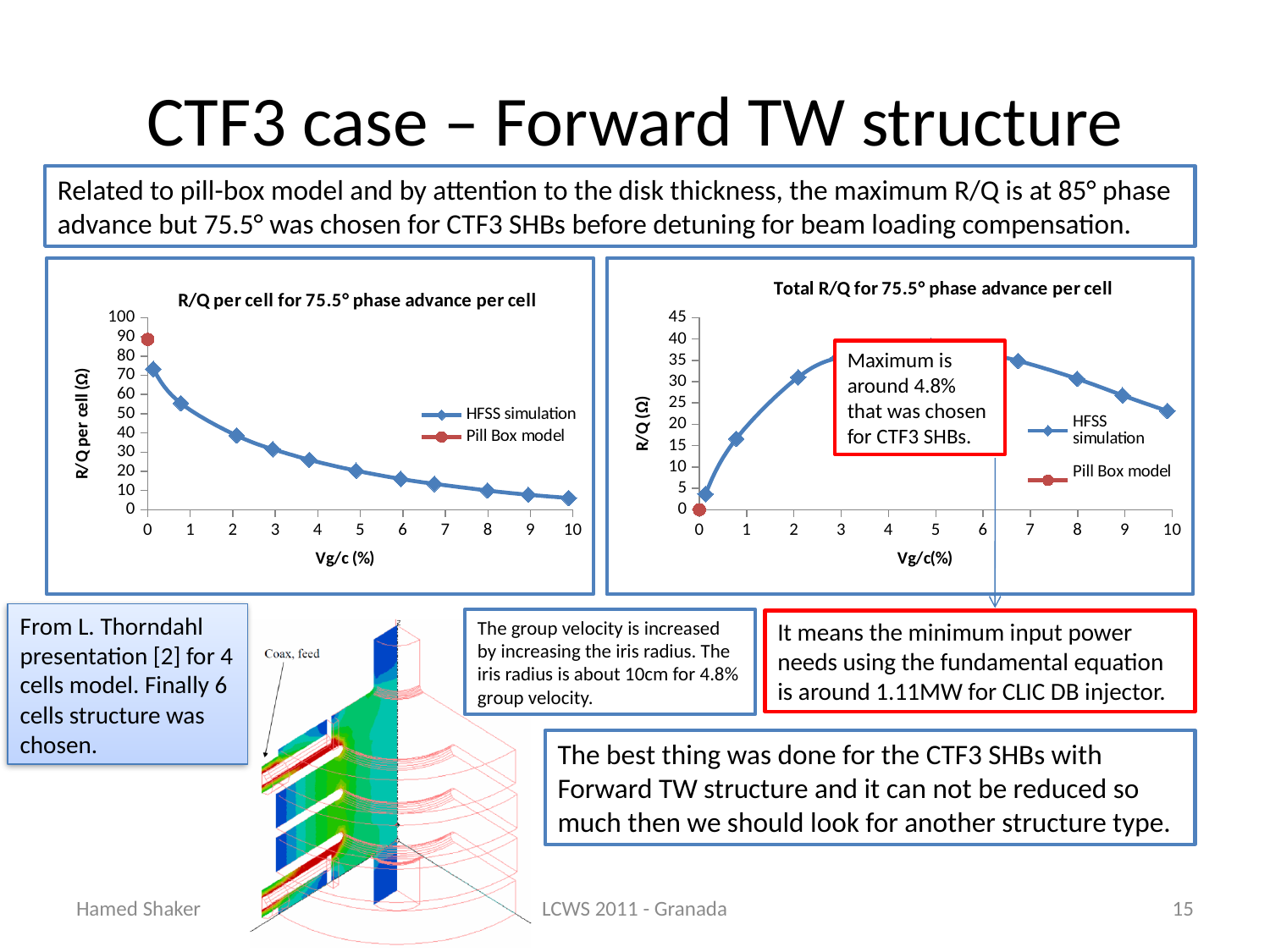
In the right chart 'Total R/Q for 75.5° phase advance per cell', what is the Pill Box model value? 0 In the right chart 'Total R/Q for 75.5° phase advance per cell', is the HFSS simulation value at Vg/c of about 10% greater or less than 20? greater In the left chart 'R/Q per cell for 75.5° phase advance per cell', is the Pill Box model value greater or less than 80? greater In the left chart 'R/Q per cell for 75.5° phase advance per cell', which is larger near Vg/c = 0: the Pill Box model value or the HFSS simulation value? Pill Box model What is the x-axis label of the right chart 'Total R/Q for 75.5° phase advance per cell'? Vg/c(%) In the right chart 'Total R/Q for 75.5° phase advance per cell', which HFSS simulation value is larger: at Vg/c of about 1% or at about 9%? about 9% What kind of chart is the left chart titled 'R/Q per cell for 75.5° phase advance per cell'? line chart In the left chart 'R/Q per cell for 75.5° phase advance per cell', do the HFSS simulation values rise or fall as Vg/c increases? fall In the left chart 'R/Q per cell for 75.5° phase advance per cell', is the HFSS simulation value at Vg/c of about 10% greater or less than 10? less What is the y-axis label of the left chart 'R/Q per cell for 75.5° phase advance per cell'? R/Q per cell (Ω) How many series does the legend of the right chart 'Total R/Q for 75.5° phase advance per cell' list? 2